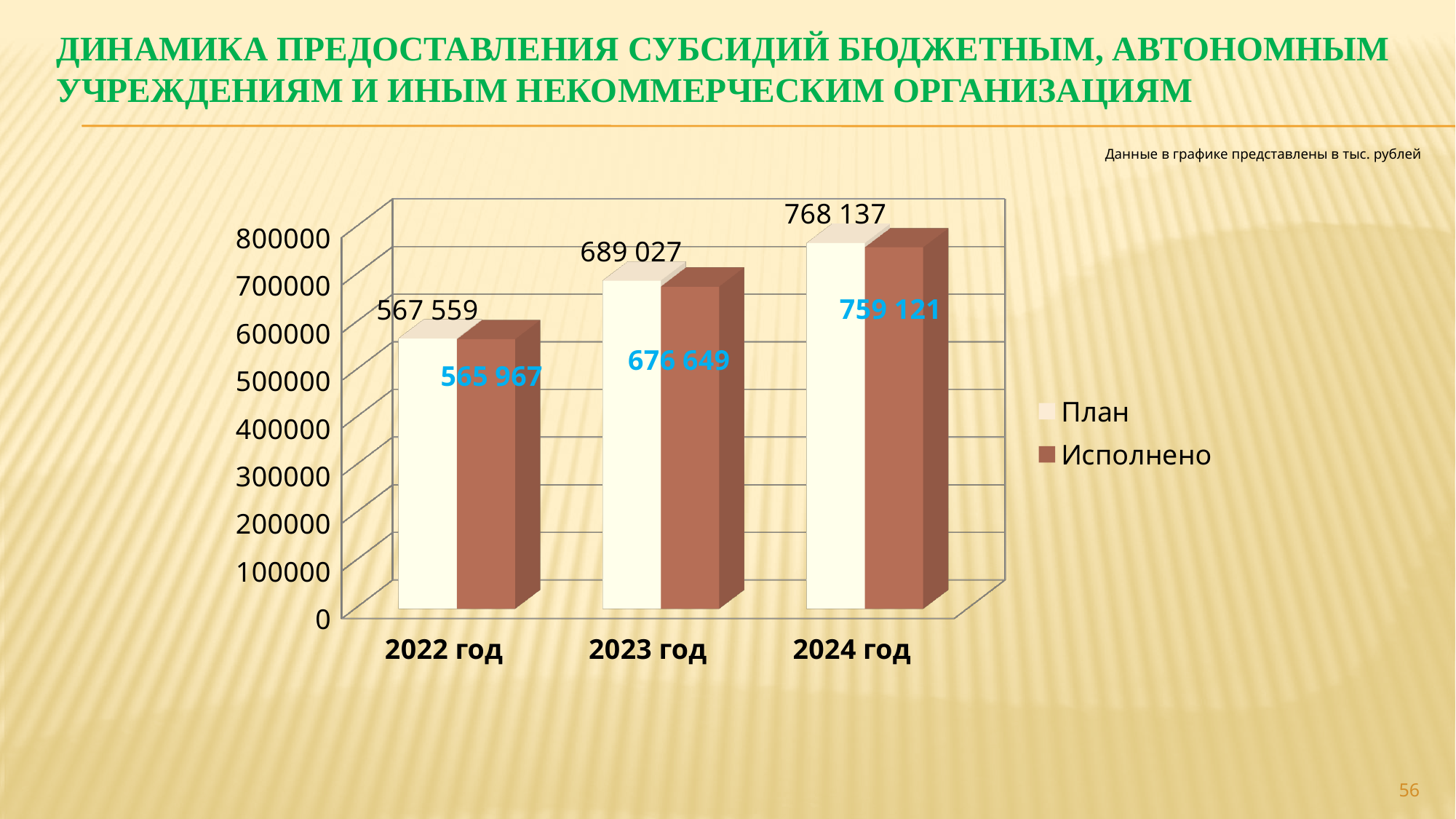
What is the План value for 2024 год? 768 137 What is the Исполнено value for 2023 год? 676 649 Which year has the highest Исполнено value? 2024 год What is the Исполнено value for 2024 год? 759 121 Do the Исполнено values rise or fall from 2022 год to 2024 год? rise How many series does the legend list? 2 Which year has the lowest План value? 2022 год Which is larger for 2024 год: План or Исполнено? План What is the difference between План and Исполнено for 2023 год? 12 378 What is the difference between the План value for 2024 год and the План value for 2022 год? 200 578 How many years are shown on the x axis? 3 What is the План value for 2022 год? 567 559